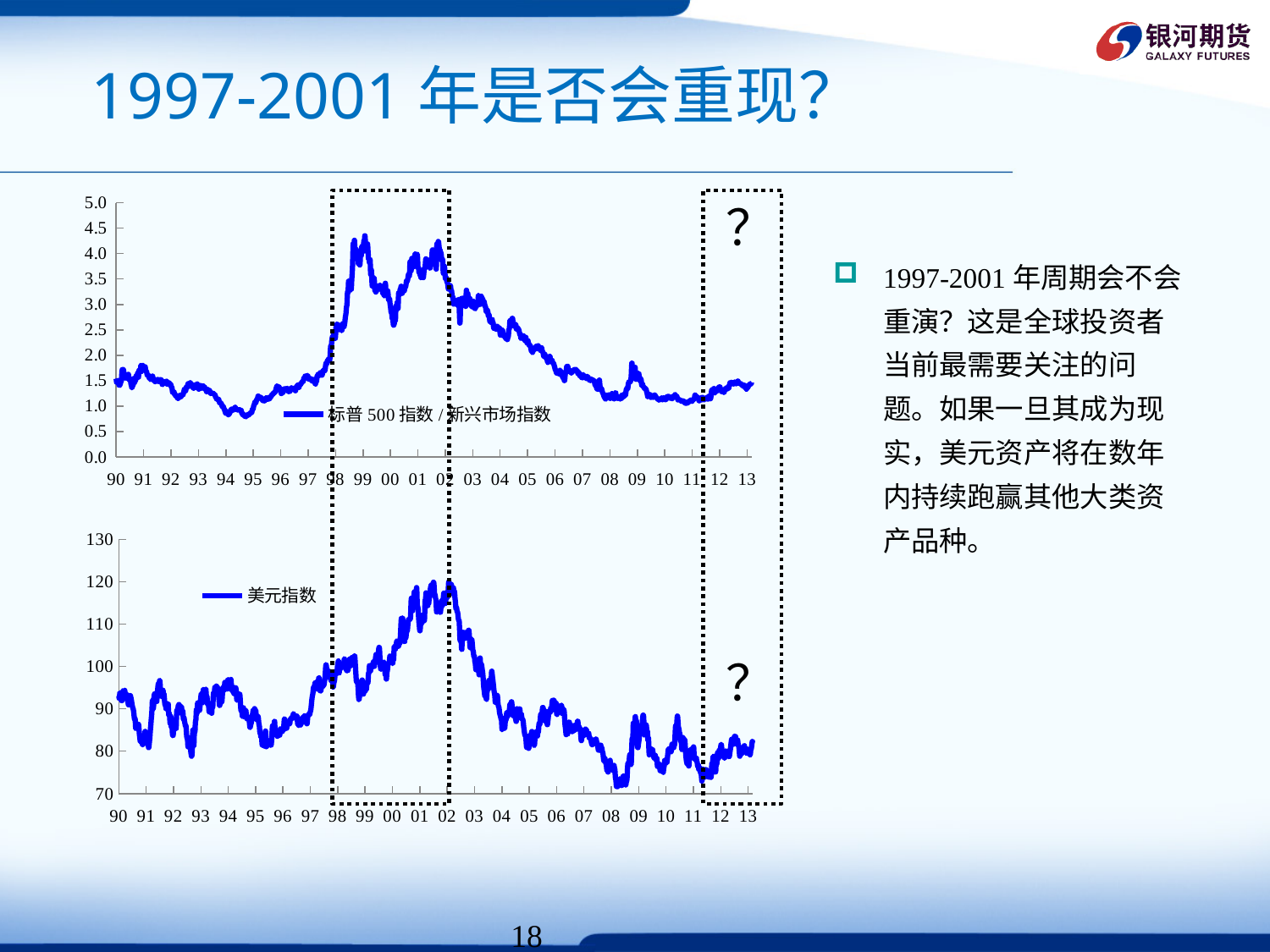
What kind of chart is the top chart on the slide? line chart In the top chart, which is larger: the value around 1999 or the value at 2013? 1999 In the top chart, is the value around 1994 greater or less than 1.0? less What kind of chart is the bottom chart on the slide? line chart In the bottom chart, is the lowest value around 2008 greater or less than 80? less In the top chart, is the peak value around 1999 greater or less than 4.0? greater In the bottom chart, does the 美元指数 rise or fall from 2002 to 2008? fall In the bottom chart, what series does the legend name? 美元指数 In the top chart, what series does the legend name? 标普500指数/新兴市场指数 How many series does the legend of the bottom chart list? 1